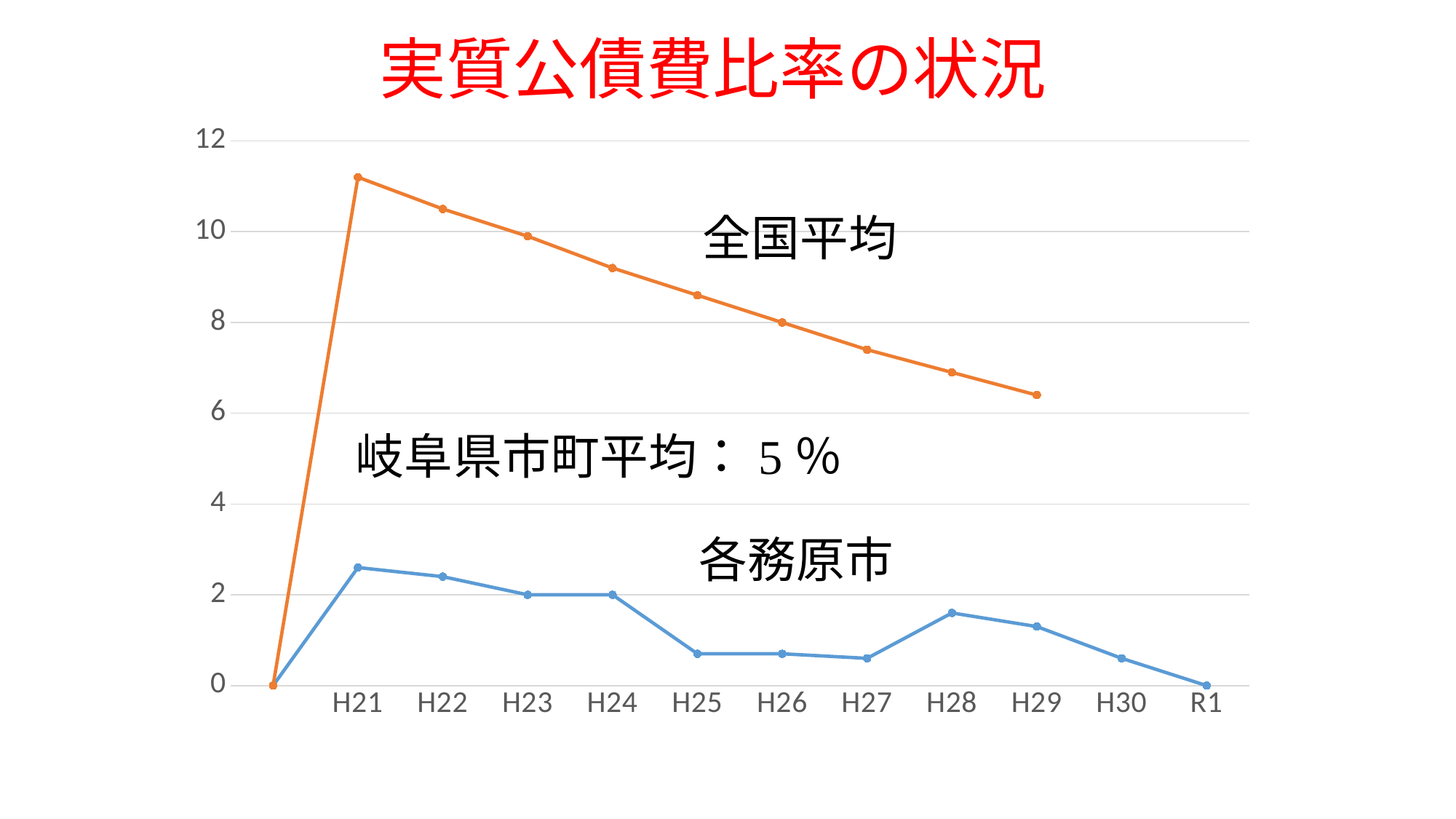
Does the 全国平均 line rise or fall from H21 to H29? fall How many series are plotted in the chart? 2 What kind of chart is shown on the slide? line chart Is the value for 各務原市 at H25 greater or less than 2? less What is the value for 各務原市 at R1? 0 Is the value for 全国平均 at H21 greater or less than 10? greater Is the value for 全国平均 at H24 greater or less than 8? greater How many year labels are shown on the x axis? 11 What is the title of the chart on the slide? 実質公債費比率の状況 At H25, which series has the larger value, 全国平均 or 各務原市? 全国平均 What value is given on the slide for 岐阜県市町平均? 5％